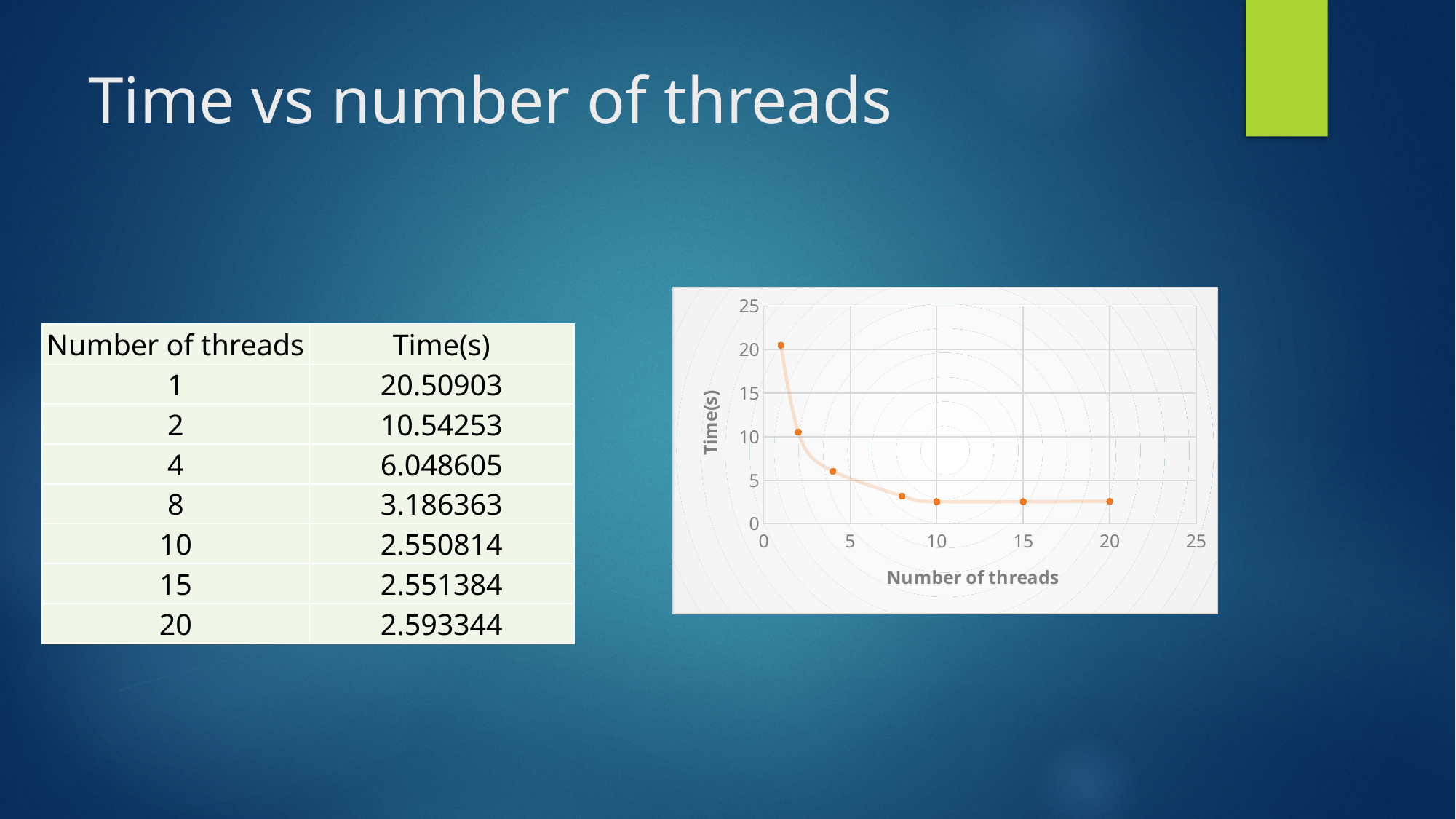
At which number of threads is the time highest? 1 What is the label of the x axis of the chart? Number of threads What is the difference in time between 1 thread and 2 threads? 9.9665 Which has a larger time, 4 threads or 8 threads? 4 threads What is the time in seconds for 8 threads? 3.186363 What is the label of the y axis of the chart? Time(s) What is the time in seconds for 1 thread? 20.50903 Is the time for 1 thread greater or less than 20? greater Does the time rise or fall as the number of threads increases along the x axis? fall How many data points are plotted in the chart? 7 What kind of chart is shown on the slide? scatter chart Is the time for 2 threads greater or less than 15? less